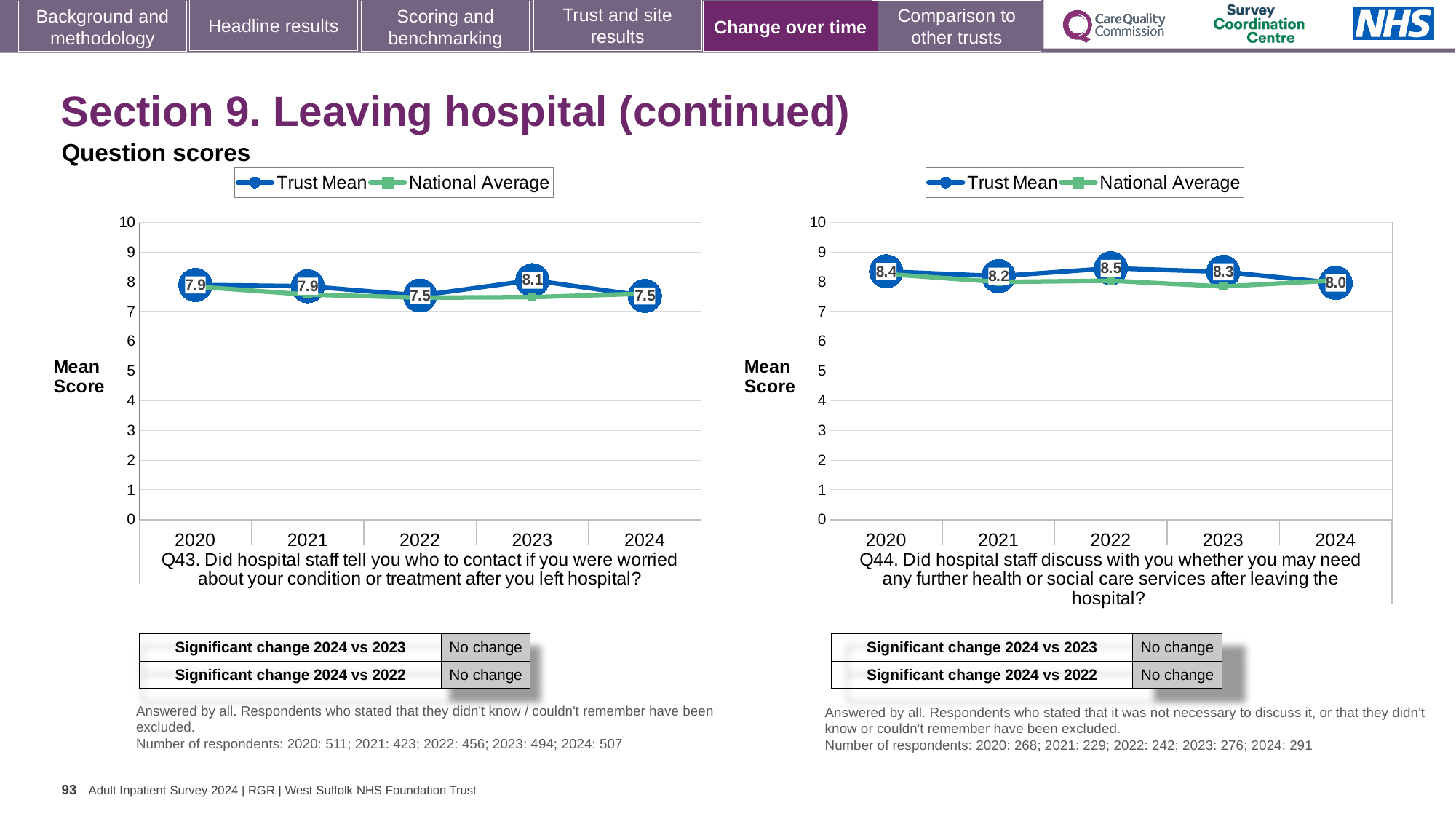
In the Q44 chart on the right, which year has the highest Trust Mean score? 2022 In the Q44 chart on the right, is the Trust Mean score higher in 2021 or in 2022? 2022 In the Q44 chart on the right, is the National Average value for 2020 greater or less than 7? greater In the Q43 chart on the left, which year has the highest Trust Mean score? 2023 In the Q44 chart on the right, what is the Trust Mean score for 2020? 8.4 In the Q44 chart on the right, which year has the lowest Trust Mean score? 2024 How many series does the legend of the Q44 chart on the right list? 2 In the Q43 chart on the left, what is the difference between the Trust Mean scores for 2023 and 2024? 0.6 In the Q44 chart on the right, does the Trust Mean score rise or fall from 2022 to 2024? fall In the Q44 chart on the right, what is the difference between the Trust Mean scores for 2022 and 2024? 0.5 In the Q43 chart on the left, what is the Trust Mean score for 2023? 8.1 How many years are plotted on the x axis of the Q43 chart on the left? 5